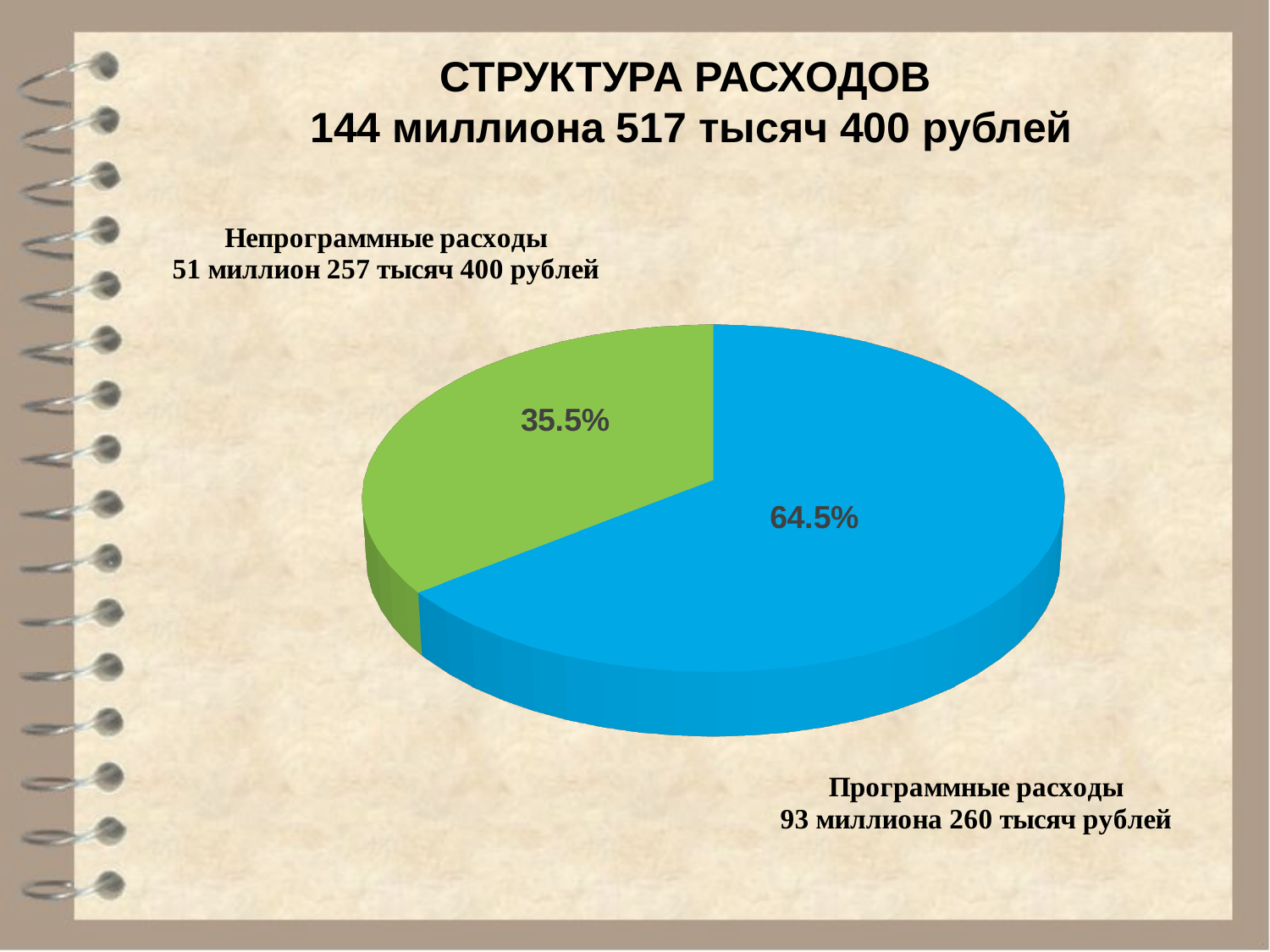
What share of the pie does Непрограммные расходы take? 35.5% Which is larger, the Программные расходы slice or the Непрограммные расходы slice? Программные расходы Which slice is the smallest? Непрограммные расходы What total amount is stated in the chart title? 144 миллиона 517 тысяч 400 рублей What is the difference in percentage points between the Программные расходы slice and the Непрограммные расходы slice? 29 percentage points Which slice is the largest? Программные расходы What amount is given for Программные расходы? 93 миллиона 260 тысяч рублей What share of the pie does Программные расходы take? 64.5% What amount is given for Непрограммные расходы? 51 миллион 257 тысяч 400 рублей How many slices does the pie chart have? 2 What colour is the Программные расходы slice? blue What kind of chart is shown on the slide? pie chart